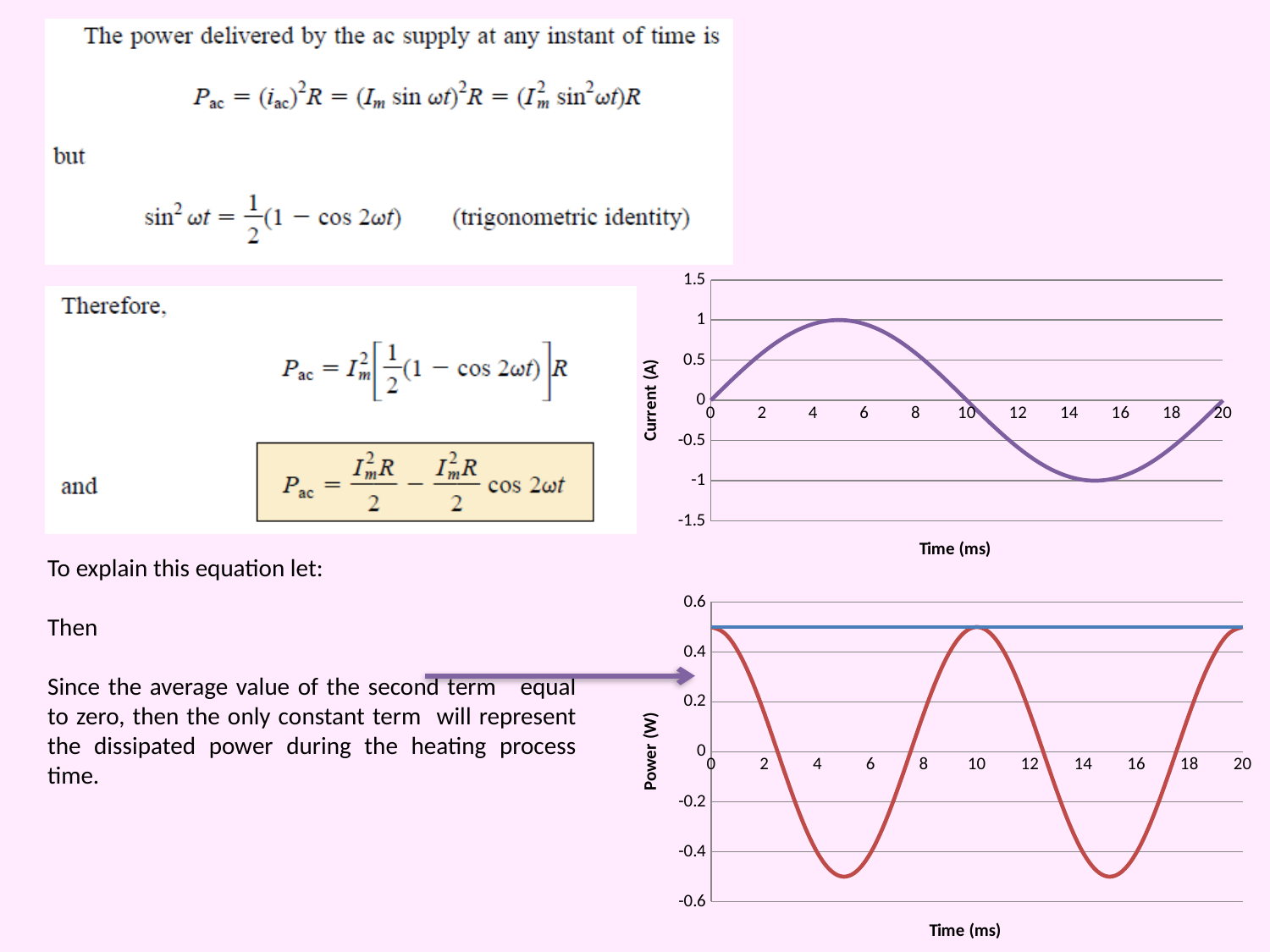
In the bottom chart, what is the label of the horizontal axis? Time (ms) In the top chart, does the current rise or fall between 6 ms and 14 ms? fall In the top chart, what is the current value at time 10 ms? 0 What kind of chart is the top chart on the right (Current vs Time)? line chart In the top chart, what is the maximum value reached by the current curve? 1 In the top chart, what is the label of the vertical axis? Current (A) In the top chart, what is the minimum value reached by the current curve? -1 In the bottom chart, at time 5 ms, which line has the larger value, the red curve or the blue line? the blue line In the bottom chart, is the value of the flat blue line greater or less than 0.4? greater In the top chart, does the current rise or fall between 0 ms and 4 ms? rise What kind of chart is the bottom chart on the right (Power vs Time)? line chart In the bottom chart, is the value of the red curve at time 5 ms greater or less than -0.4? less